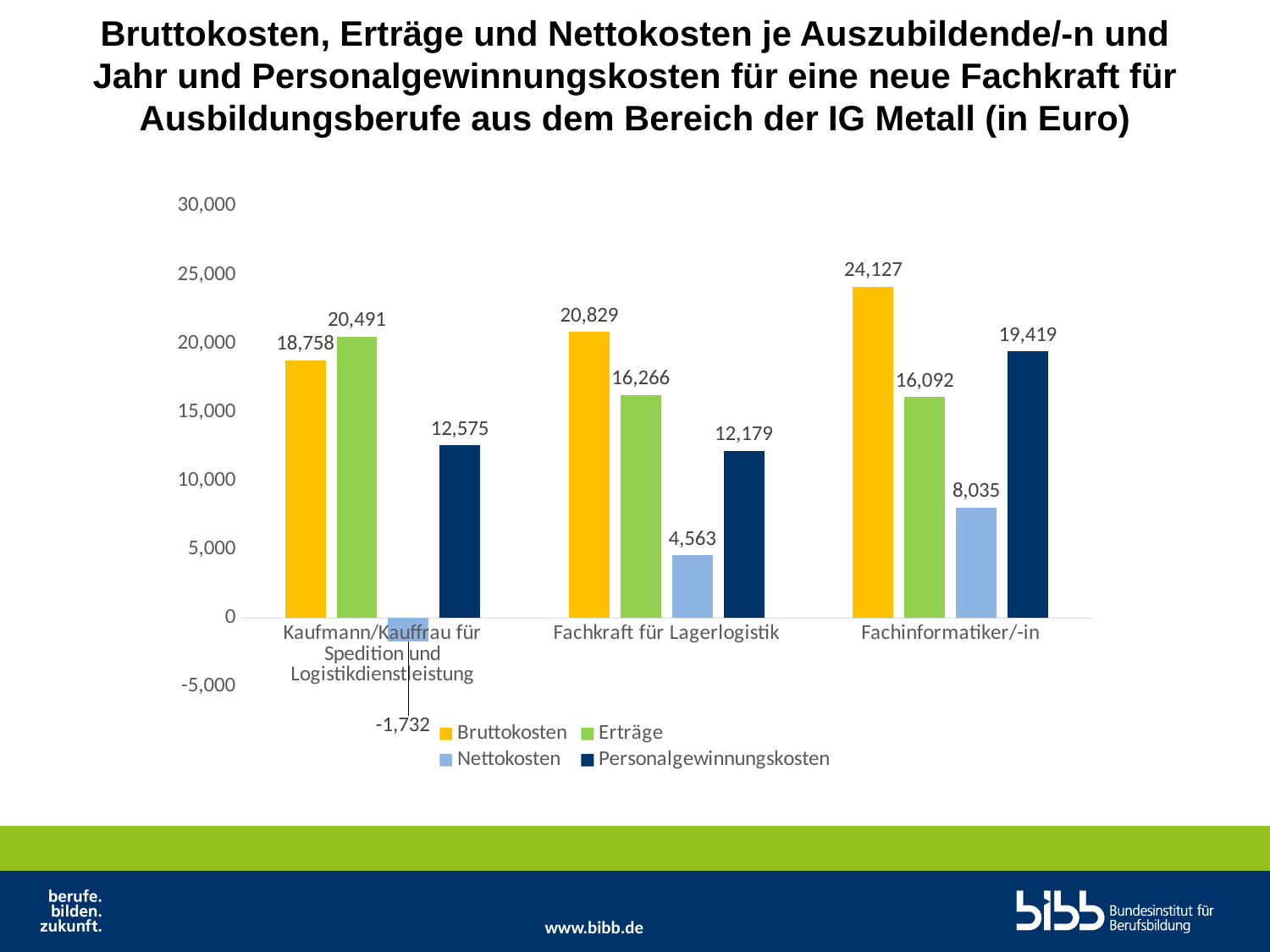
What is the Nettokosten value for Kaufmann/Kauffrau für Spedition und Logistikdienstleistung? -1,732 Which occupation has the lowest Nettokosten? Kaufmann/Kauffrau für Spedition und Logistikdienstleistung What kind of chart is shown on the slide? Bar chart What is the Personalgewinnungskosten value for Fachkraft für Lagerlogistik? 12,179 What is the difference between Bruttokosten and Erträge for Fachinformatiker/-in? 8,035 Which colour represents Personalgewinnungskosten in the legend? Dark blue What is the Erträge value for Fachkraft für Lagerlogistik? 16,266 How many series does the legend list? 4 Which occupation has the highest Bruttokosten? Fachinformatiker/-in What is the Bruttokosten value for Fachinformatiker/-in? 24,127 Which is larger for Kaufmann/Kauffrau für Spedition und Logistikdienstleistung: Bruttokosten or Erträge? Erträge How many occupations (categories) are shown on the x axis? 3